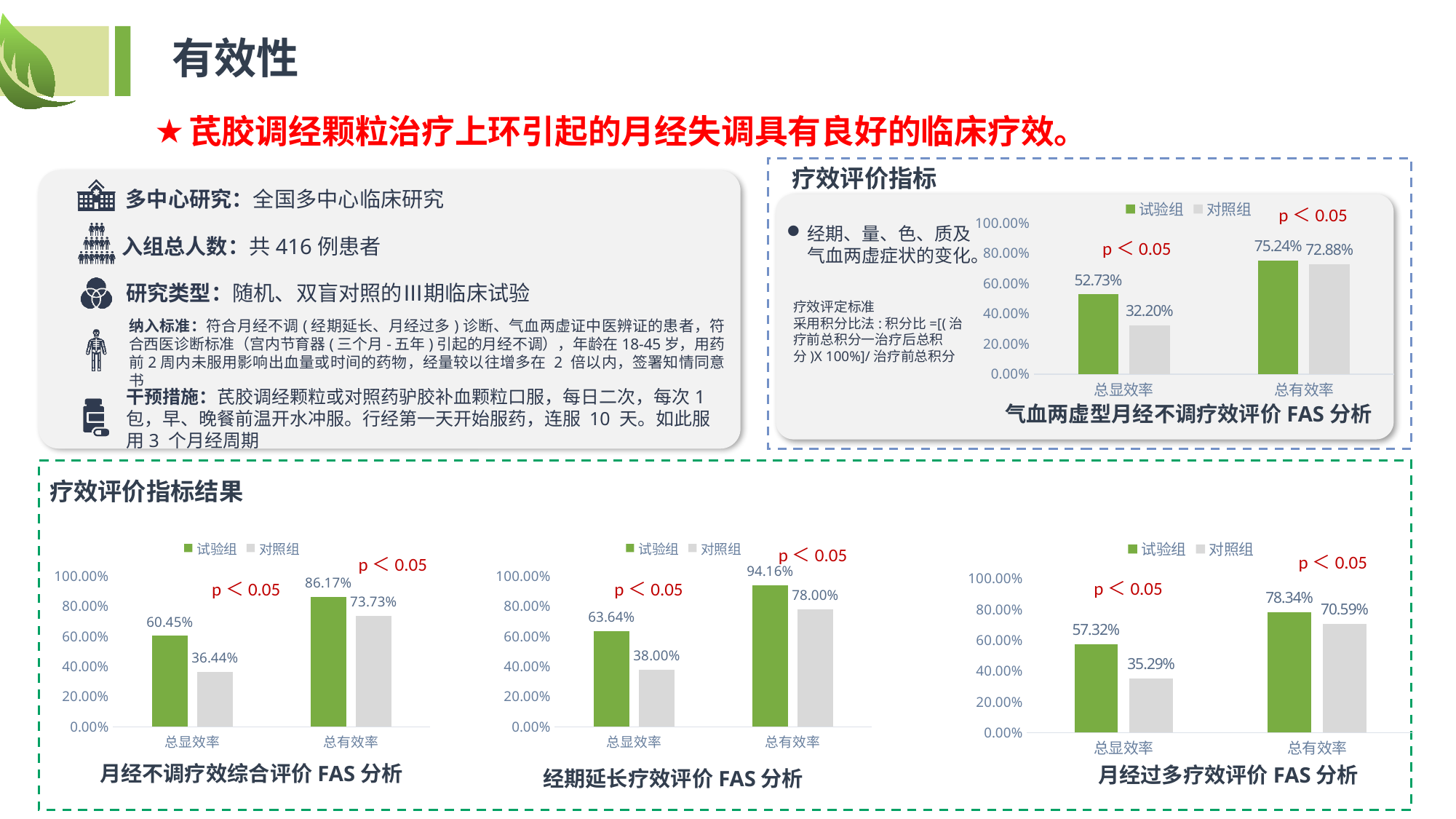
In the chart titled 经期延长疗效评价 FAS 分析, what is the difference between 试验组 and 对照组 at 总有效率? 16.16% In the chart titled 月经过多疗效评价 FAS 分析, which bar is the lowest? 对照组 at 总显效率 (35.29%) In the chart titled 气血两虚型月经不调疗效评价 FAS 分析, what is the difference between 试验组 and 对照组 at 总显效率? 20.53% What kind of chart is the one titled 月经过多疗效评价 FAS 分析? Bar chart In the chart titled 经期延长疗效评价 FAS 分析, which is larger at 总显效率, 试验组 or 对照组? 试验组 In the chart titled 气血两虚型月经不调疗效评价 FAS 分析, what is the value for 试验组 at 总显效率? 52.73% In the chart titled 月经不调疗效综合评价 FAS 分析, which bar is the highest? 试验组 at 总有效率 (86.17%) In the chart titled 月经不调疗效综合评价 FAS 分析, what is the value for 对照组 at 总显效率? 36.44% In the chart titled 月经不调疗效综合评价 FAS 分析, how many series does the legend list? 2 In the chart titled 月经过多疗效评价 FAS 分析, what is the value for 对照组 at 总显效率? 35.29% In the chart titled 经期延长疗效评价 FAS 分析, what is the value for 试验组 at 总有效率? 94.16% In the chart titled 气血两虚型月经不调疗效评价 FAS 分析, what is the value for 对照组 at 总有效率? 72.88%